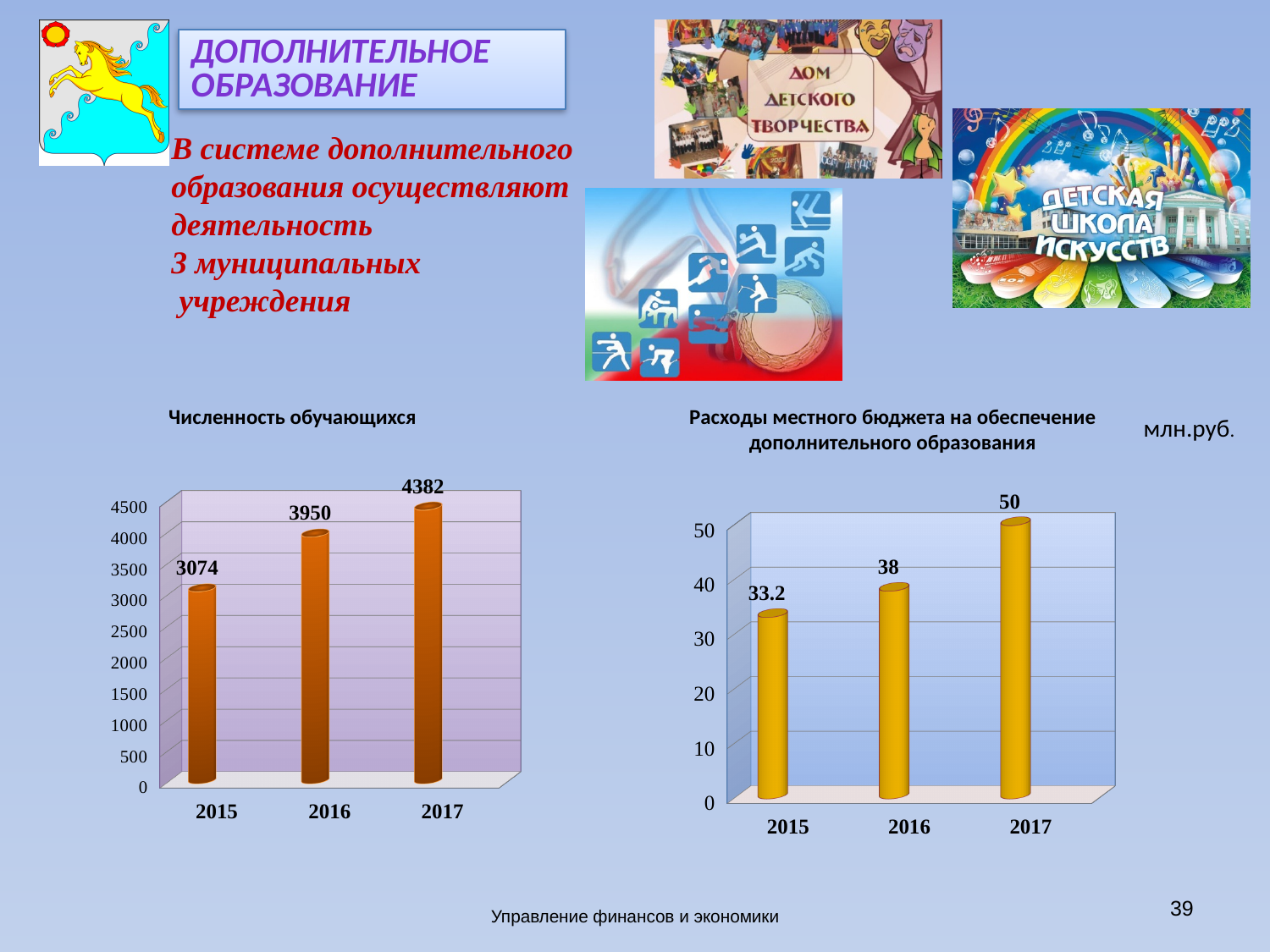
What unit is indicated next to the title of the 'Расходы местного бюджета на обеспечение дополнительного образования' chart? млн.руб. In the 'Численность обучающихся' chart, what is the value for 2015? 3074 In the 'Численность обучающихся' chart, what is the value for 2017? 4382 In the 'Расходы местного бюджета на обеспечение дополнительного образования' chart, what is the difference between the 2017 and 2015 values? 16.8 In the 'Численность обучающихся' chart, do the values rise or fall from 2015 to 2017? rise What kind of chart is the 'Расходы местного бюджета на обеспечение дополнительного образования' chart? bar chart In the 'Расходы местного бюджета на обеспечение дополнительного образования' chart, what is the value for 2016? 38 In the 'Численность обучающихся' chart, what is the difference between the 2017 and 2016 values? 432 In the 'Расходы местного бюджета на обеспечение дополнительного образования' chart, which year has the lowest value? 2015 In the 'Численность обучающихся' chart, which year has the highest value? 2017 In the 'Численность обучающихся' chart, how many years are shown? 3 In the 'Расходы местного бюджета на обеспечение дополнительного образования' chart, what is the value for 2015? 33.2